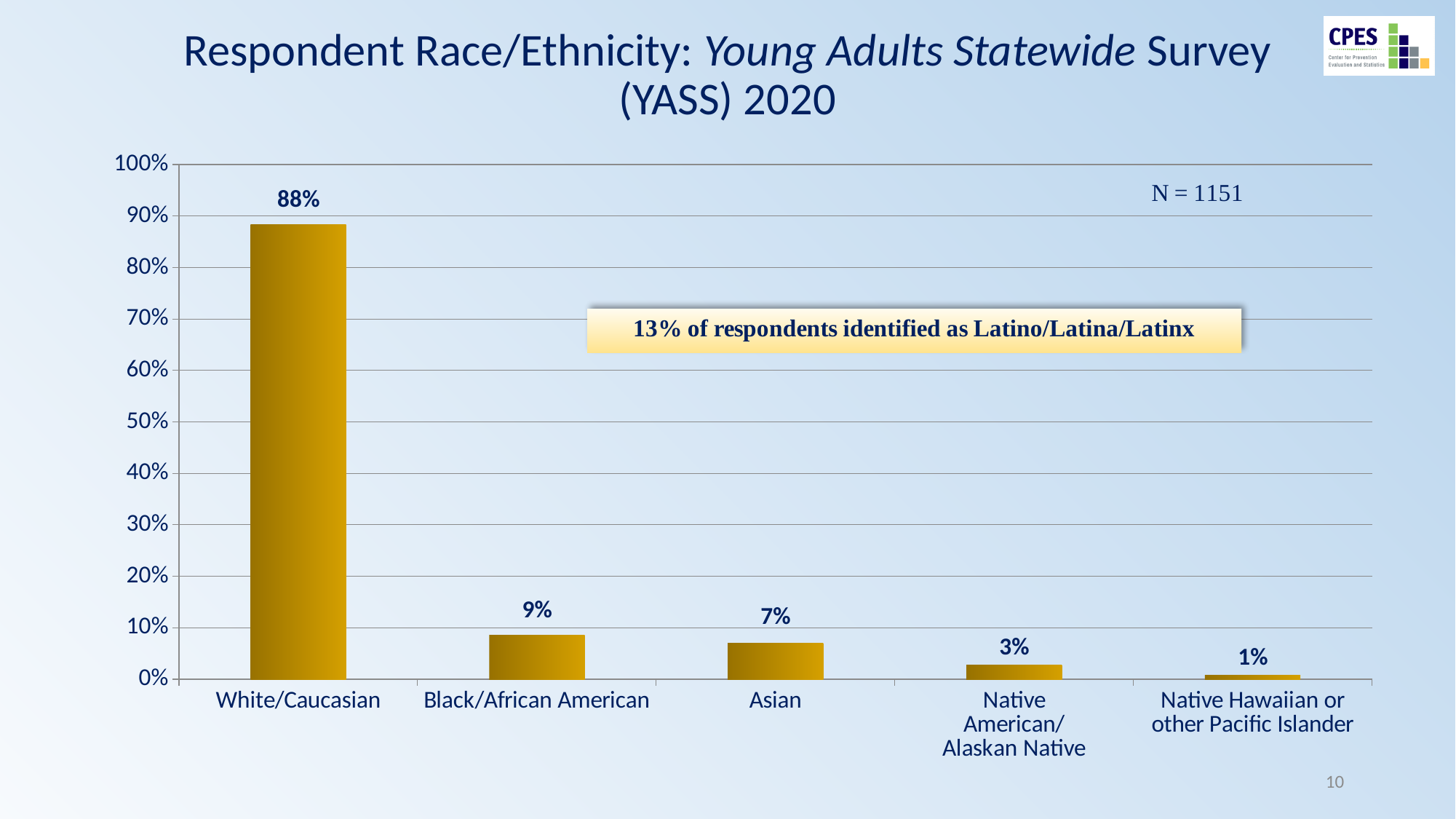
What percentage of respondents identified as Native Hawaiian or other Pacific Islander? 1% Which is larger, the percentage for Black/African American or for Asian respondents? Black/African American How many race/ethnicity categories are shown on the chart? 5 What is the sample size (N) shown on the chart? N = 1151 Which race/ethnicity category has the highest percentage of respondents? White/Caucasian What percentage of respondents identified as Native American/Alaskan Native? 3% Which race/ethnicity category has the lowest percentage of respondents? Native Hawaiian or other Pacific Islander What percentage of respondents identified as Black/African American? 9% What kind of chart is shown on the slide? Bar chart What percentage of respondents identified as White/Caucasian? 88% What percentage of respondents identified as Asian? 7% What is the difference in percentage points between White/Caucasian and Black/African American respondents? 79